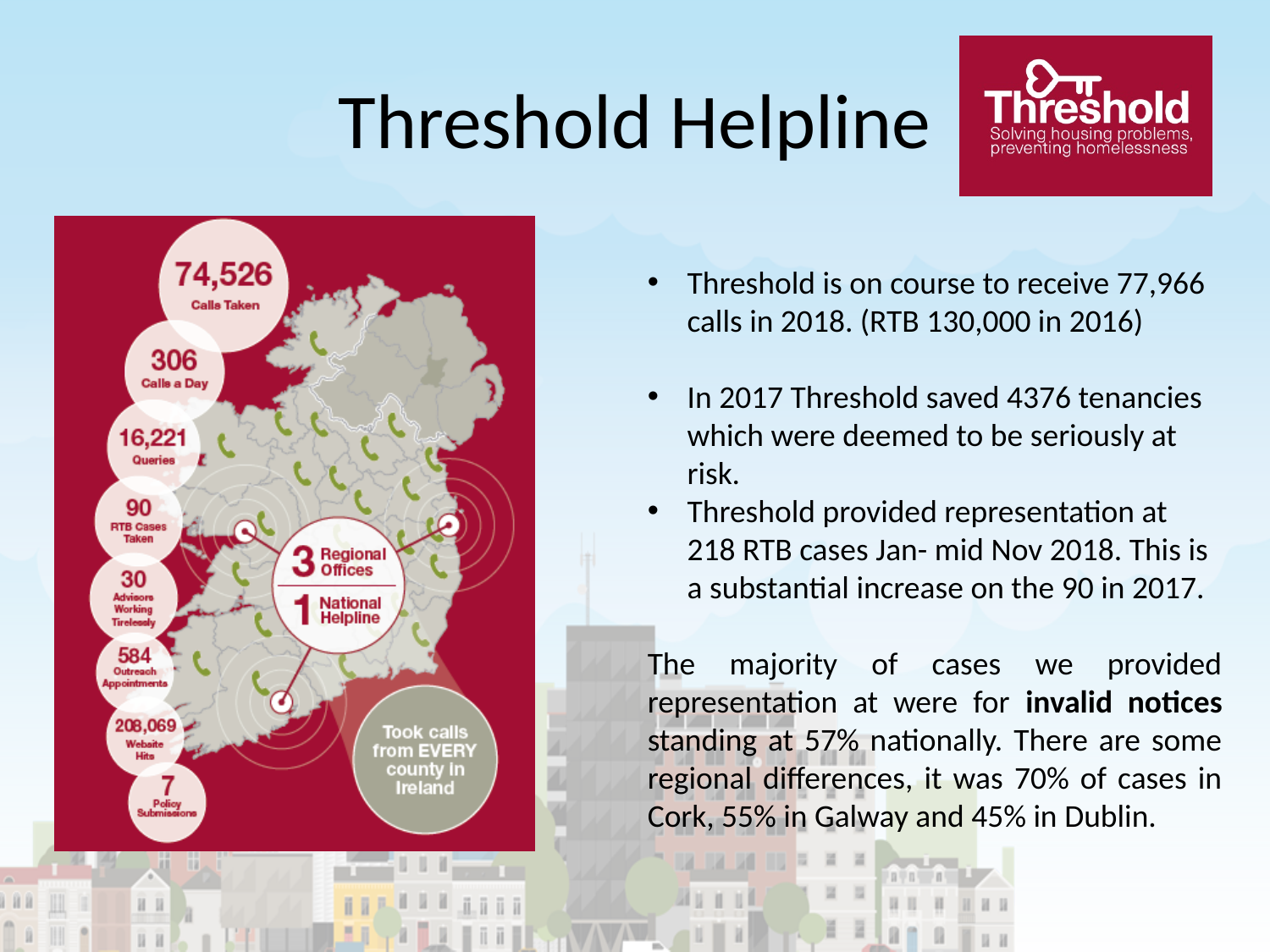
In the infographic, how many RTB cases were taken? 90 In the infographic, how many regional offices are shown on the map? 3 In the infographic, which is larger: Queries or Outreach Appointments? Queries In the infographic, which statistic in the column of circles has the largest value? Website Hits In the infographic, which statistic in the column of circles has the smallest value? Policy Submissions In the infographic, what is the difference between Calls Taken and Queries? 58,305 In the infographic, how many website hits are shown? 208,069 In the infographic, how many outreach appointments are shown? 584 How many statistic circles are stacked down the left side of the infographic? 8 In the infographic, how many calls a day are shown? 306 In the infographic, how many queries are shown? 16,221 In the infographic, how many calls were taken? 74,526